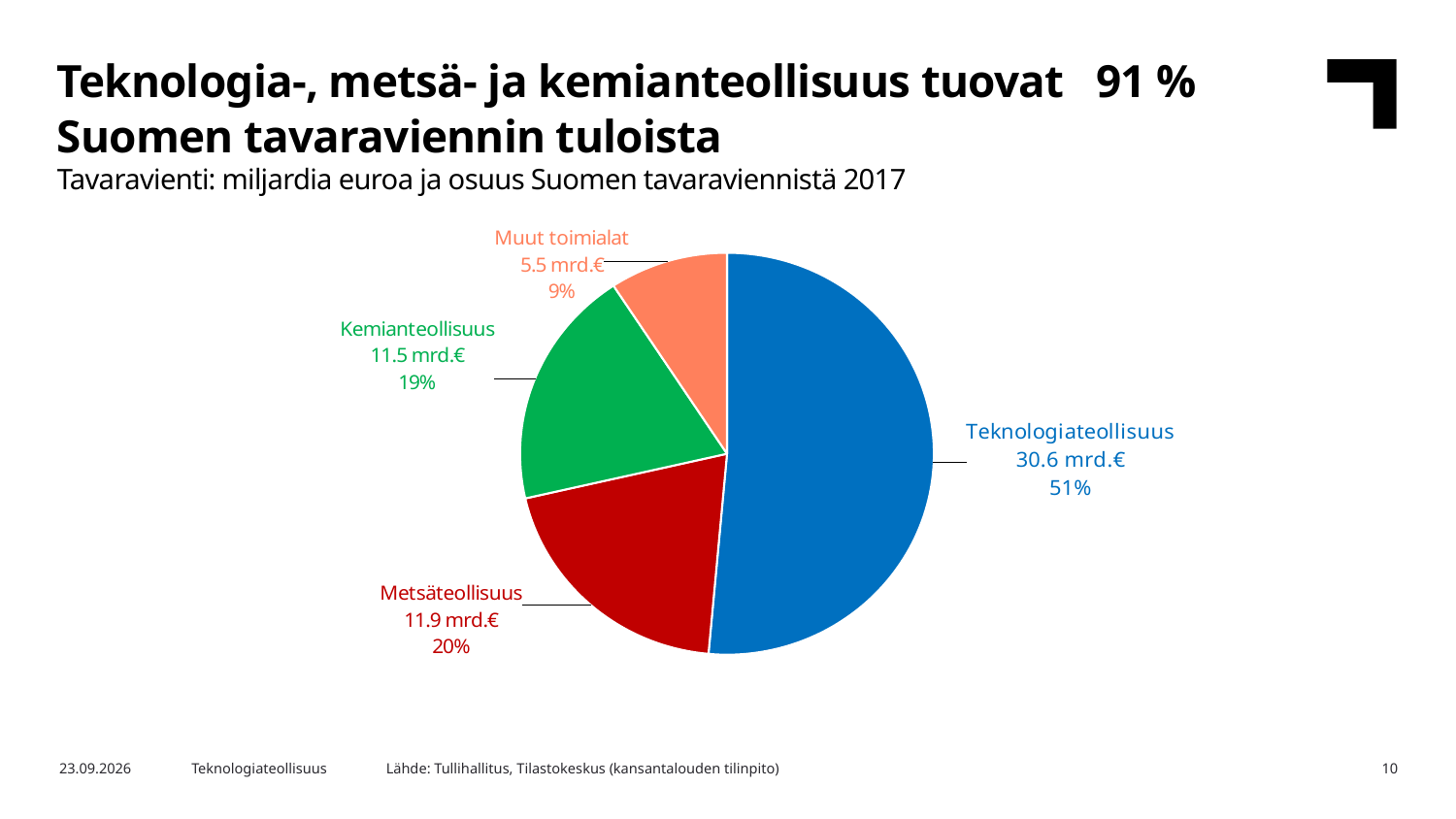
How many slices does the pie chart have? 4 What is the difference in value between Teknologiateollisuus and Metsäteollisuus? 18.7 mrd.€ What colour is the Metsäteollisuus slice? red What kind of chart is shown on the slide? pie chart What share of the pie does Teknologiateollisuus represent? 51% What share of the pie does Metsäteollisuus represent? 20% What is the value for Kemianteollisuus? 11.5 mrd.€ What is the value for Teknologiateollisuus? 30.6 mrd.€ Which slice is the smallest? Muut toimialat Which slice is the largest? Teknologiateollisuus What is the value for Muut toimialat? 5.5 mrd.€ Which is larger, the value for Kemianteollisuus or the value for Muut toimialat? Kemianteollisuus